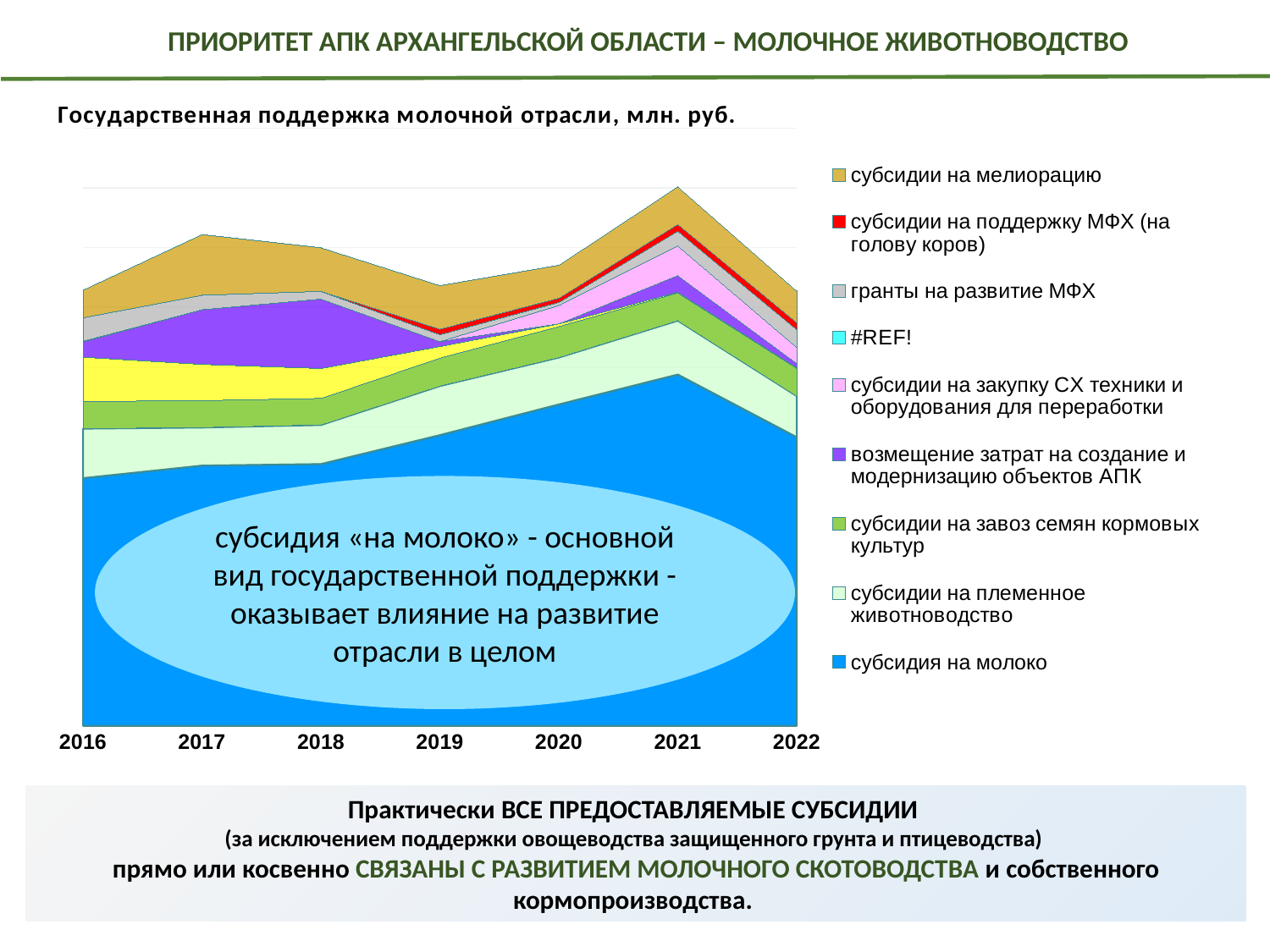
What kind of chart is shown on the slide? Area chart Is the value of 'субсидия на молоко' larger in 2021 or in 2016? 2021 Which year has the highest total state support in the chart? 2021 How many years are shown on the x axis of the chart? 7 Does the total state support rise or fall from 2021 to 2022? Fall What is the first year shown on the x axis of the chart? 2016 How many series does the chart legend list? 9 Does the total state support rise or fall from 2019 to 2021? Rise Is the total state support larger in 2021 or in 2019? 2021 Which series occupies the largest area in the chart? субсидия на молоко What is the title of the chart? Государственная поддержка молочной отрасли, млн. руб.